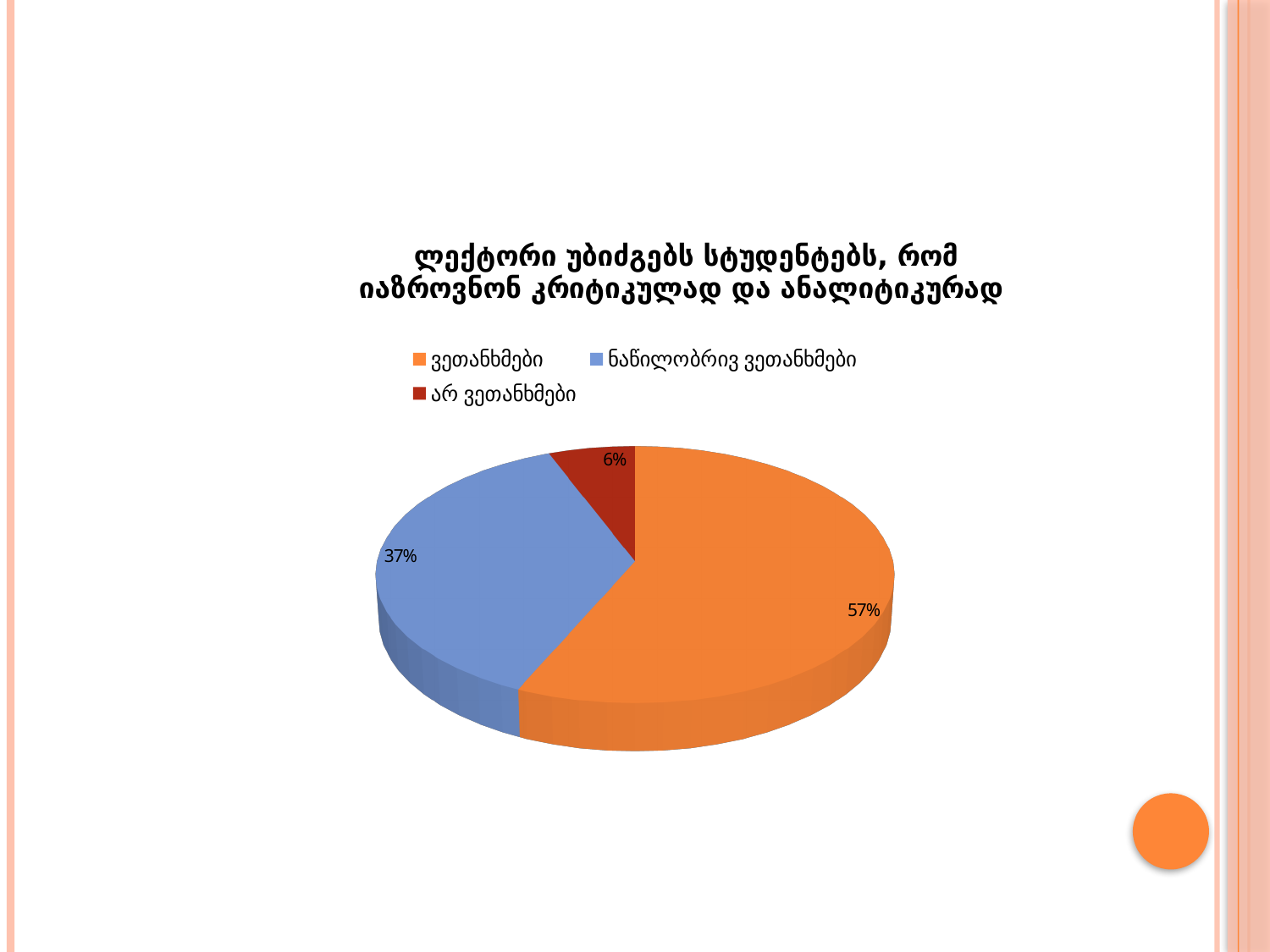
What percentage of the pie is the slice for არ ვეთანხმები? 6% Which category has the largest slice of the pie? ვეთანხმები What is the title of the chart? ლექტორი უბიძგებს სტუდენტებს, რომ იაზროვნონ კრიტიკულად და ანალიტიკურად What kind of chart is shown on the slide? pie chart What is the difference in percentage points between the ვეთანხმები slice and the ნაწილობრივ ვეთანხმები slice? 20 What is the difference in percentage points between the ნაწილობრივ ვეთანხმები slice and the არ ვეთანხმები slice? 31 Which category has the smallest slice of the pie? არ ვეთანხმები What percentage of the pie is the slice for ნაწილობრივ ვეთანხმები? 37% Which slice is larger: ნაწილობრივ ვეთანხმები or არ ვეთანხმები? ნაწილობრივ ვეთანხმები How many slices does the pie chart have? 3 What colour is the slice for არ ვეთანხმები? dark red What percentage of the pie is the slice for ვეთანხმები? 57%